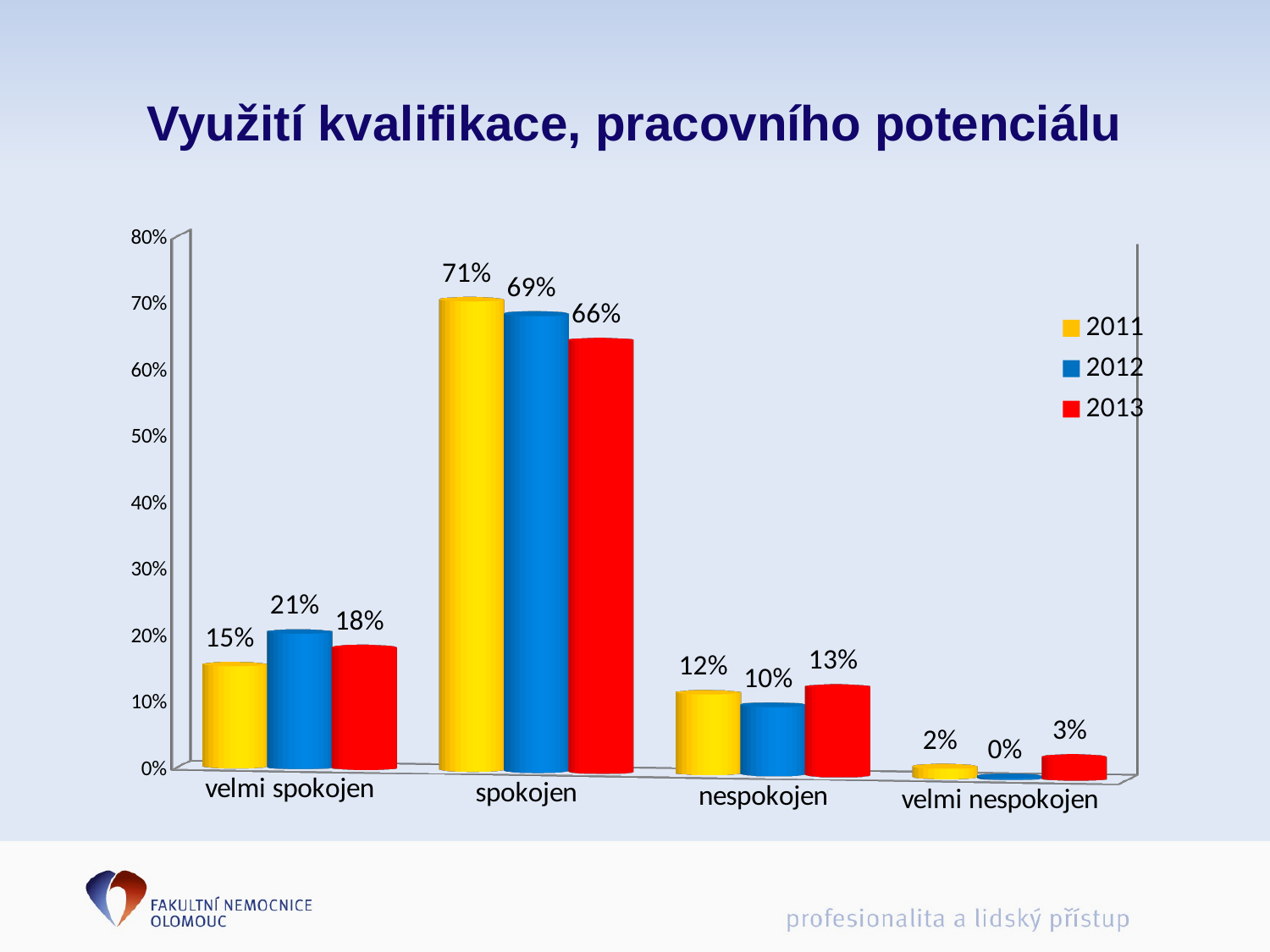
What kind of chart is shown on the slide? bar chart Which category has the highest value in 2013? spokojen What is the value for 'spokojen' in 2011? 71% What is the title of the chart? Využití kvalifikace, pracovního potenciálu How many series does the legend list? 3 What is the difference between the 2011 and 2013 values for 'spokojen'? 5% What is the value for 'velmi nespokojen' in 2013? 3% What is the value for 'velmi spokojen' in 2012? 21% How many categories are shown on the x axis? 4 What is the value for 'nespokojen' in 2012? 10% Which is larger for 'nespokojen': the 2011 value or the 2013 value? 2013 Which category has the lowest value in 2012? velmi nespokojen